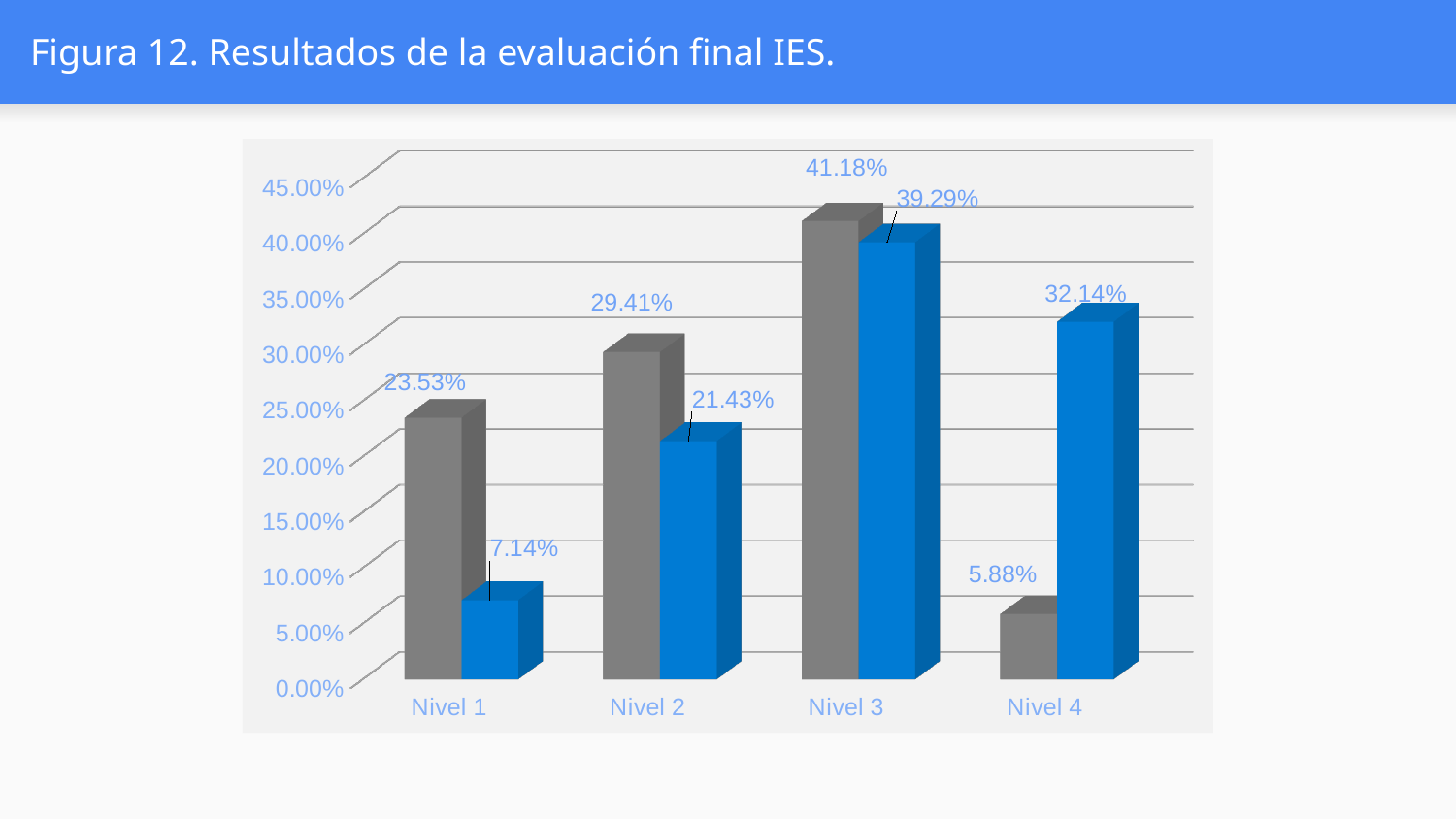
What is the value of the blue bar for Nivel 1? 7.14% What is the value of the grey bar for Nivel 2? 29.41% Which is larger for Nivel 4, the grey bar or the blue bar? the blue bar What is the value of the grey bar for Nivel 3? 41.18% How many categories are shown on the x axis? 4 Which category has the highest grey bar? Nivel 3 What is the title of the slide containing the chart? Figura 12. Resultados de la evaluación final IES. What kind of chart is shown on the slide? bar chart Which category has the lowest grey bar? Nivel 4 What is the difference between the grey bar and the blue bar for Nivel 1? 16.39% What is the value of the blue bar for Nivel 4? 32.14% Which category has the lowest blue bar? Nivel 1